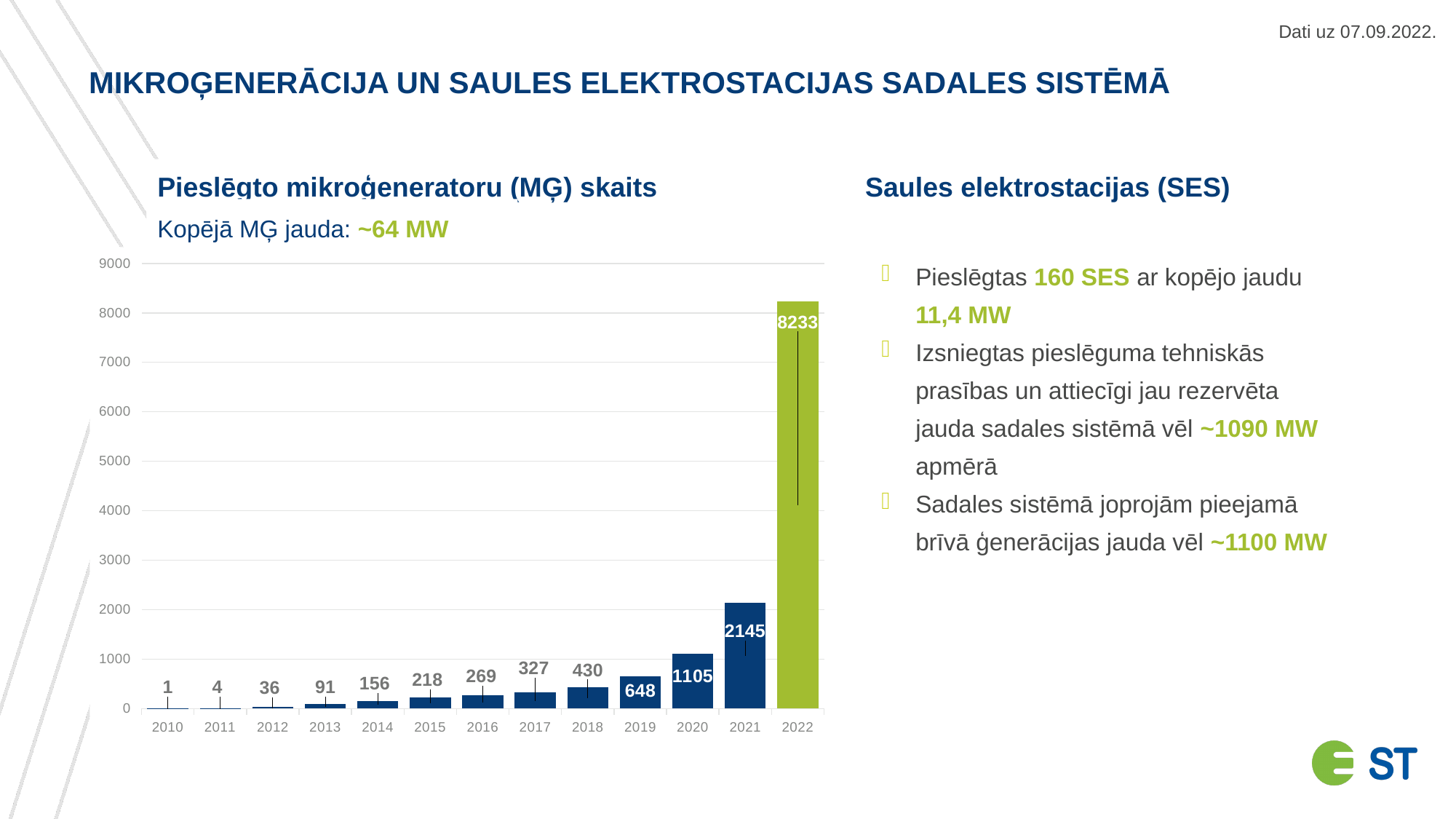
What is the difference between the values for 2022 and 2021? 6088 How many years are shown on the x axis of the chart? 13 Which is larger, the value for 2018 or the value for 2017? 2018 What is the value for 2022 in the chart? 8233 Do the values rise or fall from 2010 to 2022? rise Which year has the highest value in the chart? 2022 What is the value for 2015 in the chart? 218 Which year has the lowest value in the chart? 2010 What kind of chart is shown on the slide? bar chart Is the value for 2021 greater or less than 2000? greater What is the difference between the values for 2020 and 2019? 457 What is the value for 2019 in the chart? 648